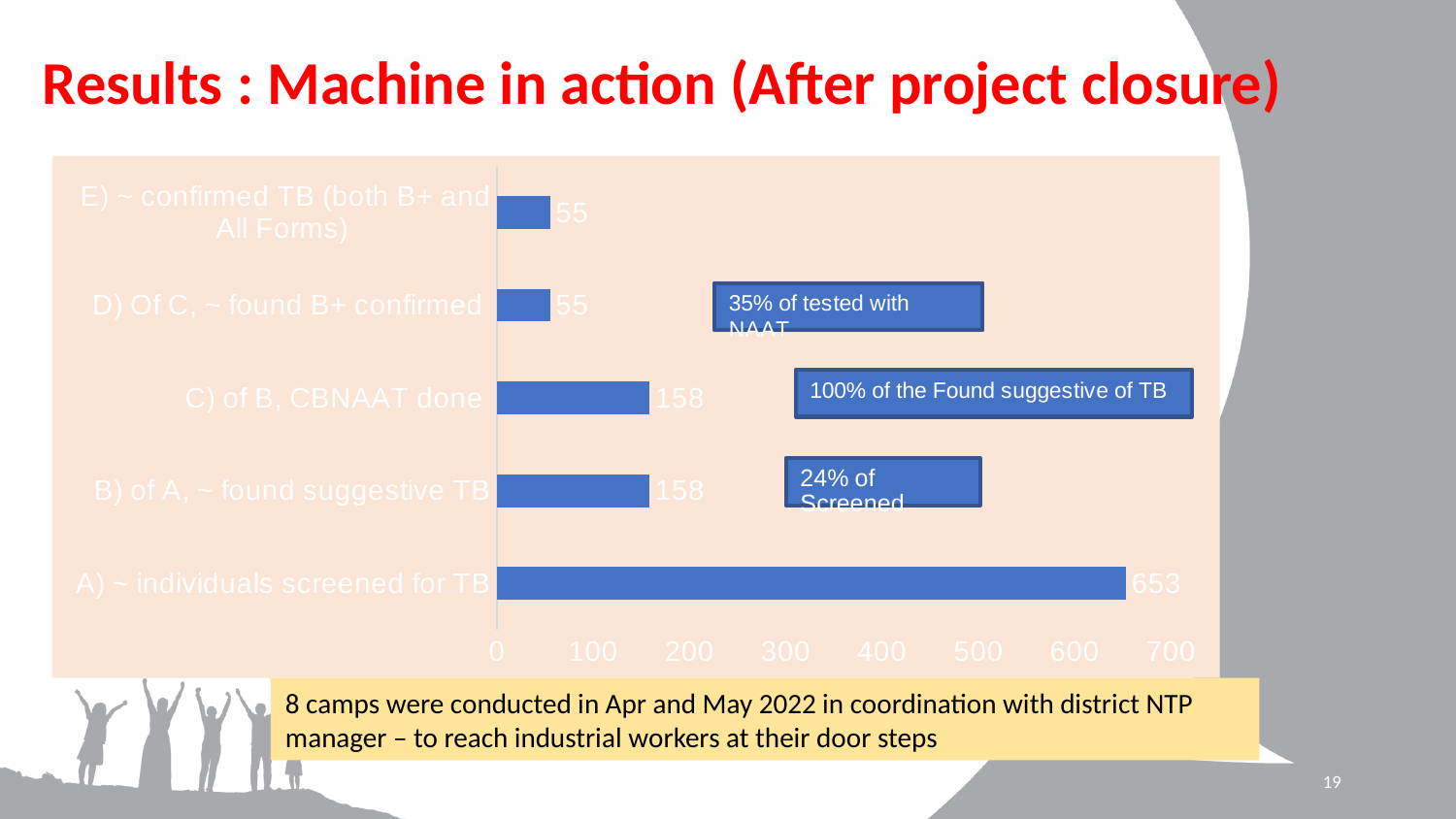
Which is larger, the value for "B) of A, ~ found suggestive TB" or the value for "E) ~ confirmed TB (both B+ and All Forms)"? B) of A, ~ found suggestive TB What is the difference between the value for "C) of B, CBNAAT done" and the value for "D) Of C, ~ found B+ confirmed"? 103 What is the value for "C) of B, CBNAAT done"? 158 What is the value for "B) of A, ~ found suggestive TB"? 158 What is the value for "D) Of C, ~ found B+ confirmed"? 55 Which category has the highest value? A) ~ individuals screened for TB How many categories does the bar chart show? 5 What is the difference between the value for "A) ~ individuals screened for TB" and the value for "B) of A, ~ found suggestive TB"? 495 What kind of chart is shown on the slide? bar chart What is the value for "A) ~ individuals screened for TB"? 653 What is the value for "E) ~ confirmed TB (both B+ and All Forms)"? 55 Is the value for "A) ~ individuals screened for TB" greater or less than 600? greater